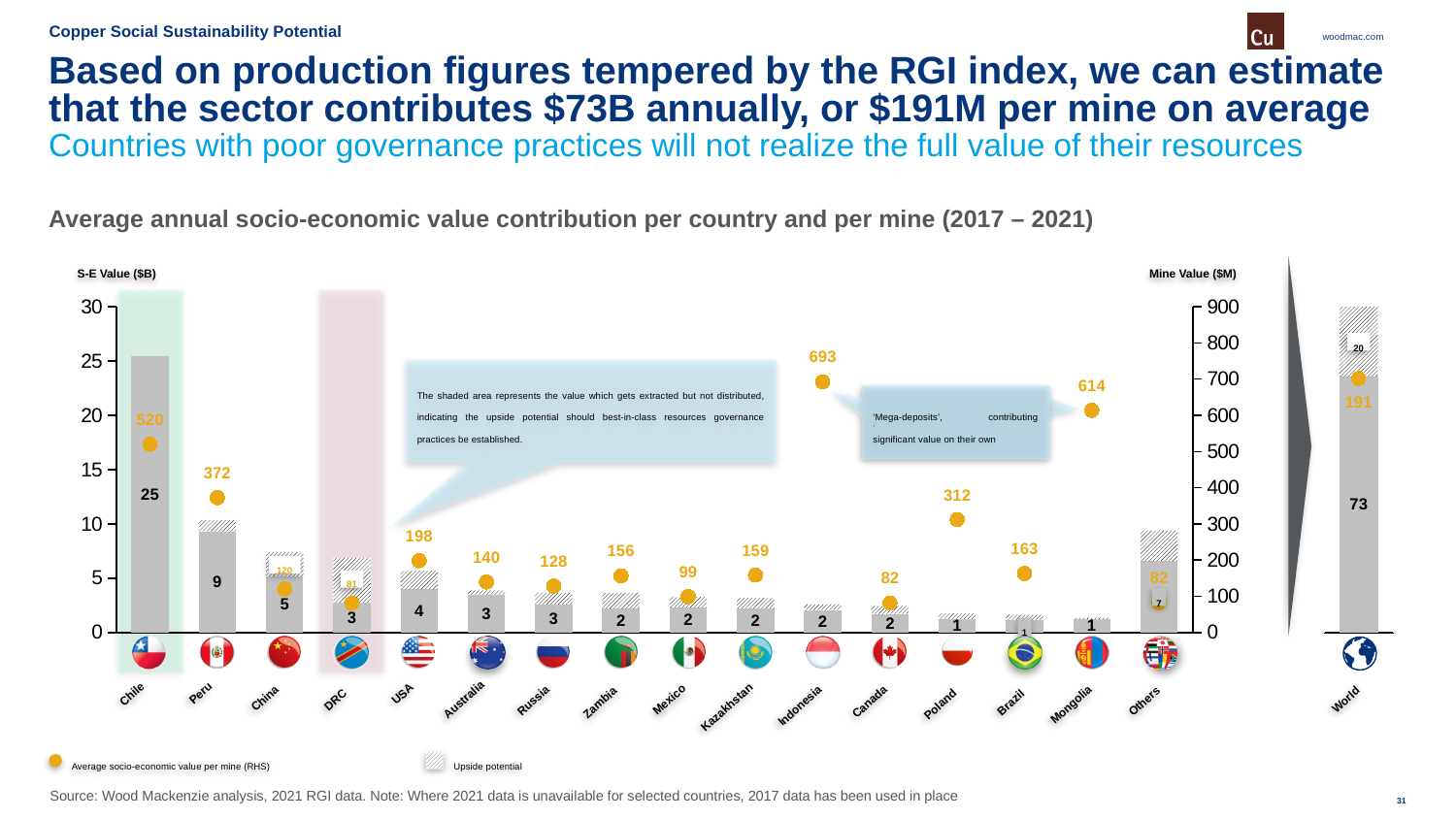
What does the hatched pattern in the legend represent? Upside potential What is the average socio-economic value per mine ($M) for Peru? 372 What is the S-E Value ($B) bar for Chile? 25 Which country has the highest average socio-economic value per mine? Indonesia Which has a higher average socio-economic value per mine, Mongolia or Brazil? Mongolia What is the difference between the average socio-economic value per mine for Indonesia and Mongolia? 79 What is the difference between the S-E Value ($B) bars for Chile and Peru? 16 Which country has the tallest S-E Value ($B) bar? Chile What is the S-E Value ($B) bar for World? 73 What kind of chart is used to show the S-E Value ($B) by country? Bar chart What is the average socio-economic value per mine ($M) for World? 191 What is the average socio-economic value per mine ($M) for Indonesia? 693